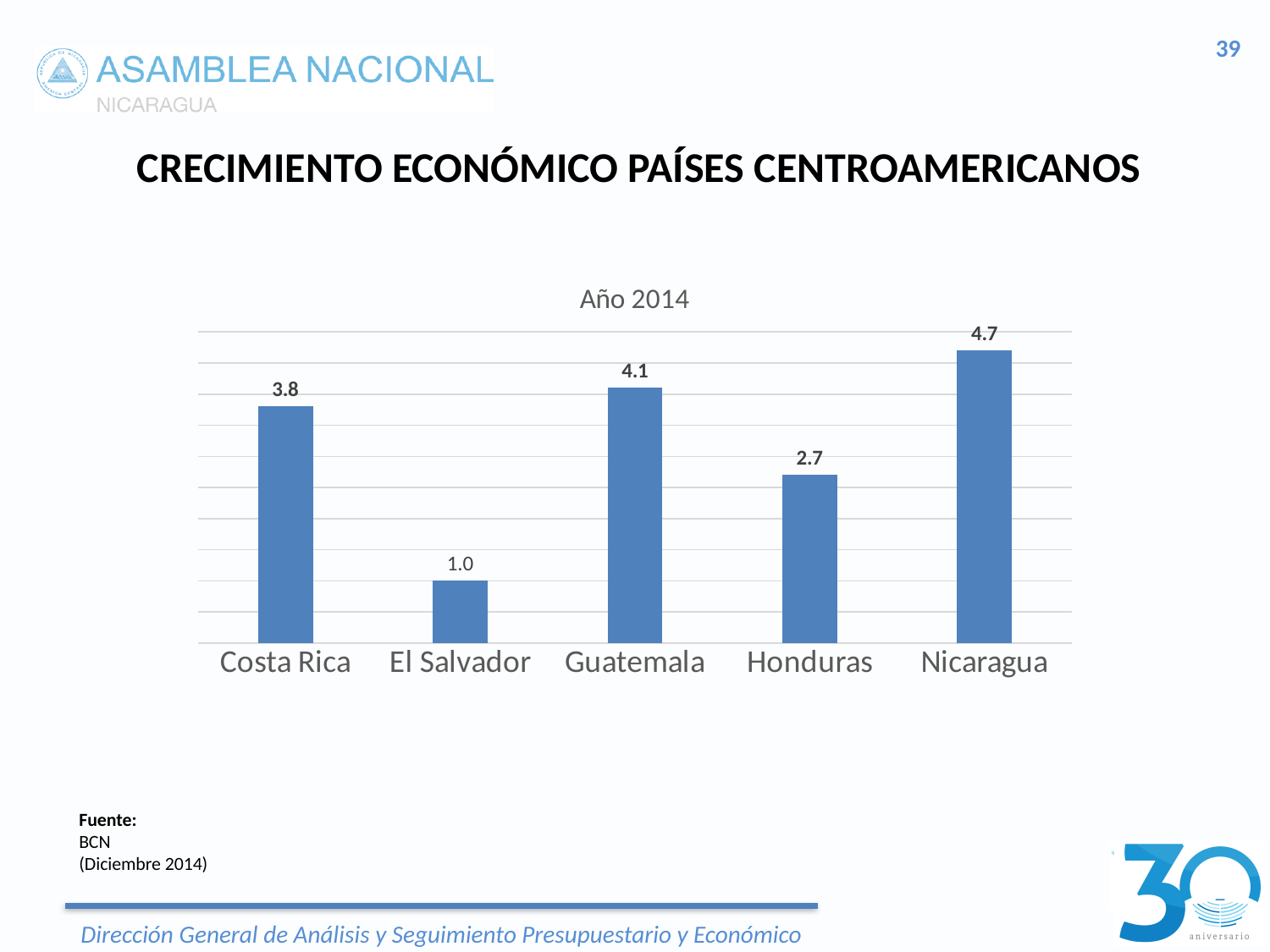
What is the value for Nicaragua? 4.7 What is the value for El Salvador? 1.0 What is the value for Costa Rica? 3.8 What is the value for Honduras? 2.7 What is the title shown above the chart? Año 2014 Which is larger, the value for Guatemala or the value for Honduras? Guatemala What is the difference between the values for Nicaragua and Costa Rica? 0.9 What kind of chart is shown on the slide? Bar chart What is the value for Guatemala? 4.1 How many countries are shown in the chart? 5 Which country has the lowest value? El Salvador Which country has the highest value? Nicaragua